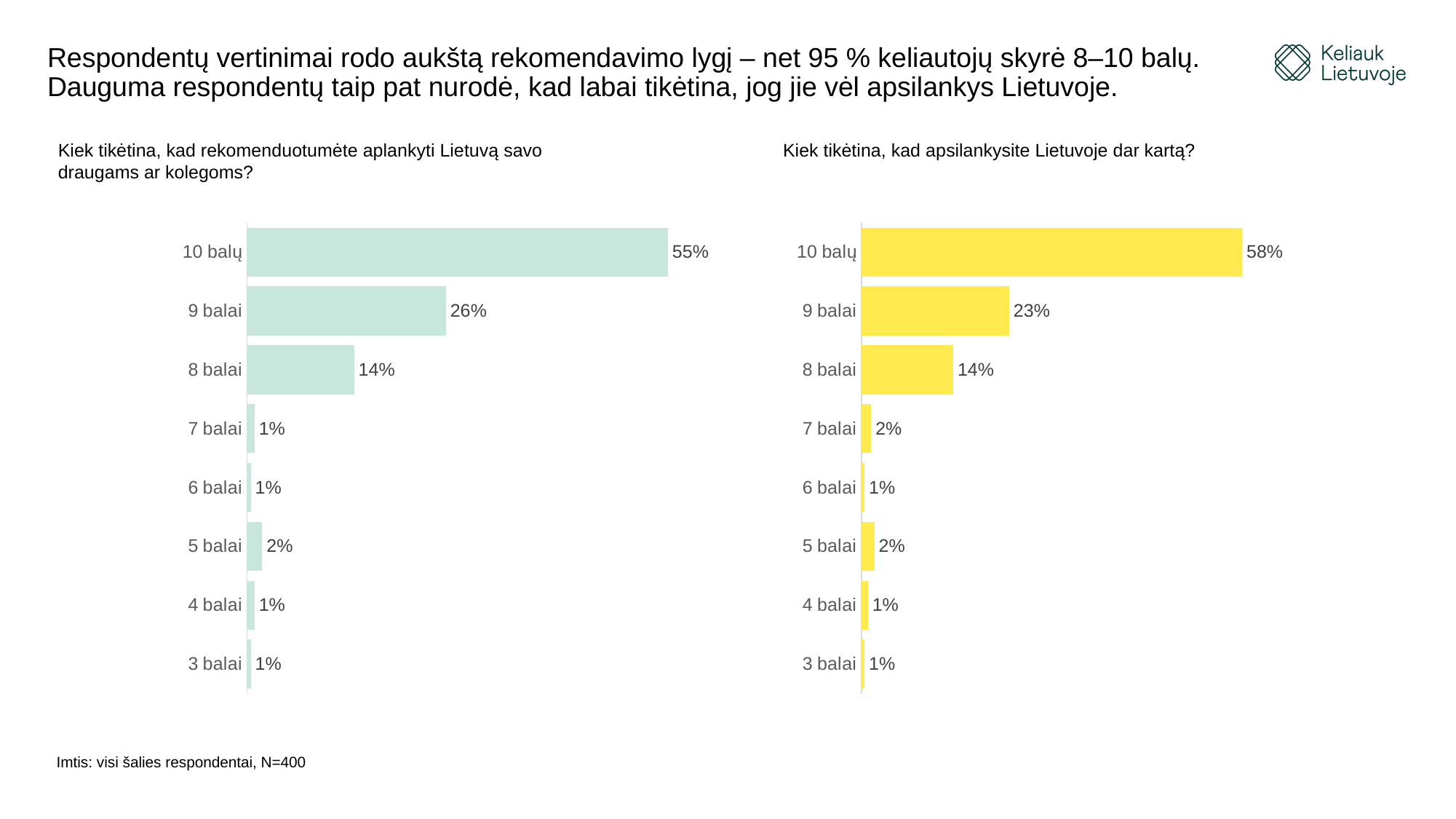
In the right chart (visiting Lithuania again), which score category has the highest percentage? 10 balų How many score categories are shown in the left chart (recommending Lithuania to friends or colleagues)? 8 In the left chart (recommending Lithuania to friends or colleagues), what percentage of respondents gave 5 balai? 2% In the right chart (visiting Lithuania again), what percentage of respondents gave 9 balai? 23% What sample size is stated at the bottom of the slide? N=400 Which is larger: the 10 balų value in the left chart or the 10 balų value in the right chart? The right chart (58%) What type of chart is used on the right side of the slide (visiting Lithuania again)? Bar chart What colour are the bars in the right chart (visiting Lithuania again)? Yellow In the right chart (visiting Lithuania again), what is the combined percentage for 8 balai, 9 balai and 10 balų? 95% In the right chart (visiting Lithuania again), what percentage of respondents gave 7 balai? 2% In the left chart (recommending Lithuania to friends or colleagues), what percentage of respondents gave 10 balų? 55% In the left chart (recommending Lithuania to friends or colleagues), what is the difference in percentage points between 10 balų and 9 balai? 29%